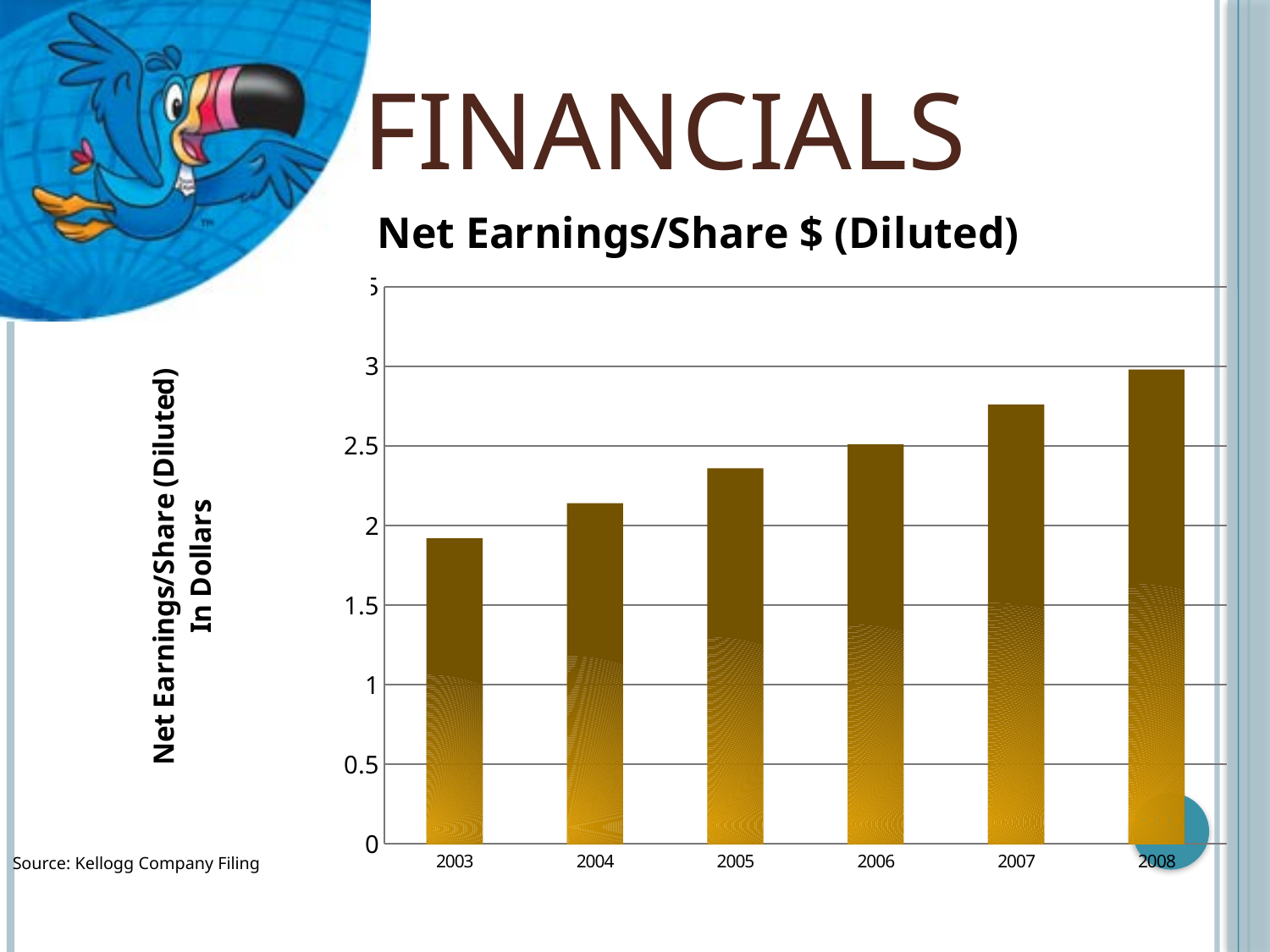
Is the value for 2004 greater or less than 2? greater Is the value for 2005 greater or less than 2.5? less Which year has the larger net earnings per share, 2004 or 2007? 2007 Is the value for 2008 greater or less than 2.5? greater What is the title of the chart? Net Earnings/Share $ (Diluted) How many years are shown on the x axis of the chart? 6 Which year has the highest net earnings per share (diluted)? 2008 What kind of chart is shown on the slide? Bar chart Do the net earnings per share values rise or fall from 2003 to 2008? Rise Which year has the lowest net earnings per share (diluted)? 2003